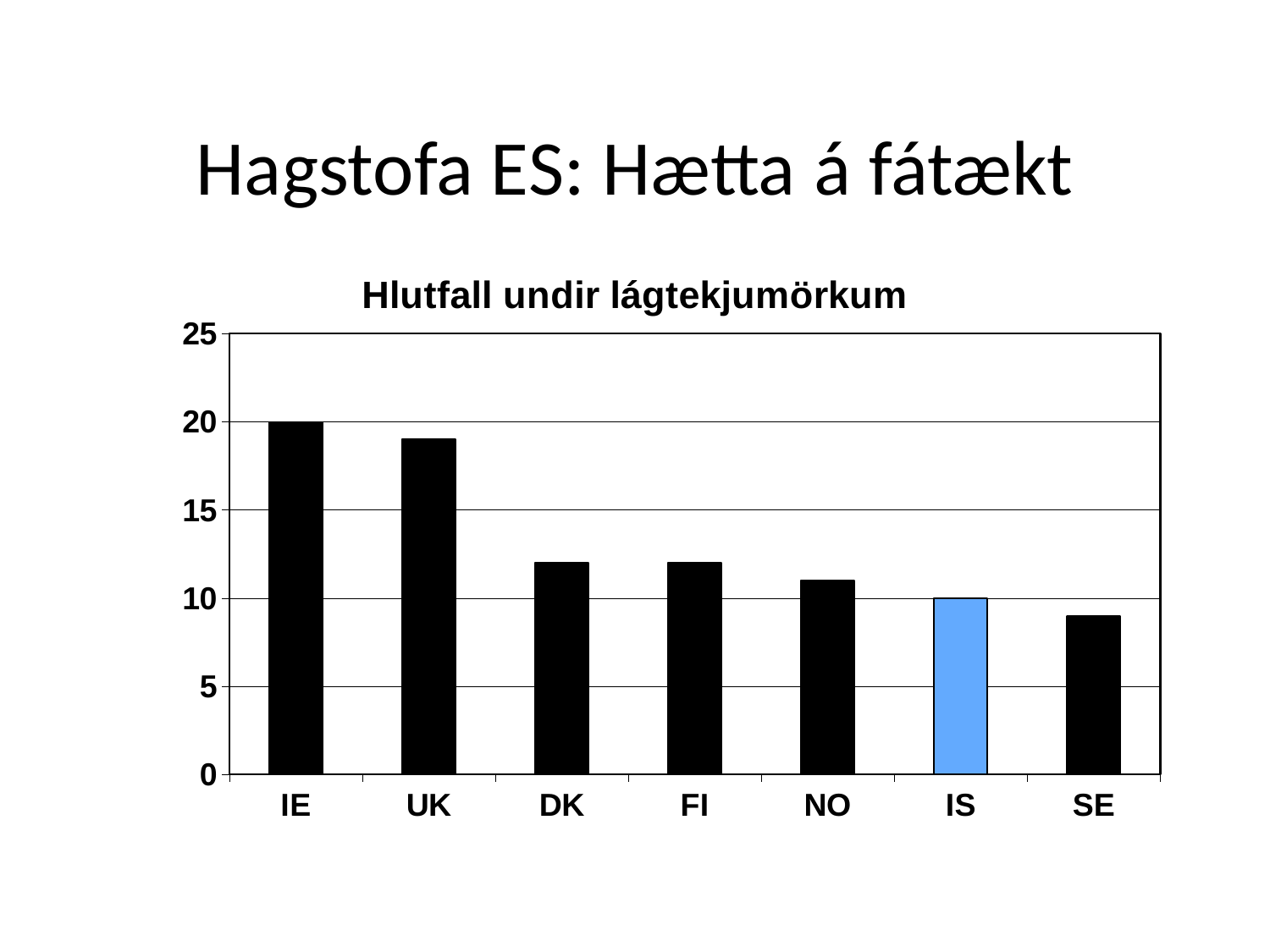
Which country has the highest value in the chart? IE Which country has the lowest value in the chart? SE Is the value for UK greater or less than 15? greater Which has the larger value, UK or NO? UK How many countries are shown on the x axis of the chart? 7 Do the values generally rise or fall from left to right along the x axis? fall Is the value for DK greater or less than 15? less What kind of chart is shown on the slide? bar chart What is the value for IE in the chart? 20 What is the value for IS in the chart? 10 Is the value for SE greater or less than 10? less What is the title of the chart? Hlutfall undir lágtekjumörkum